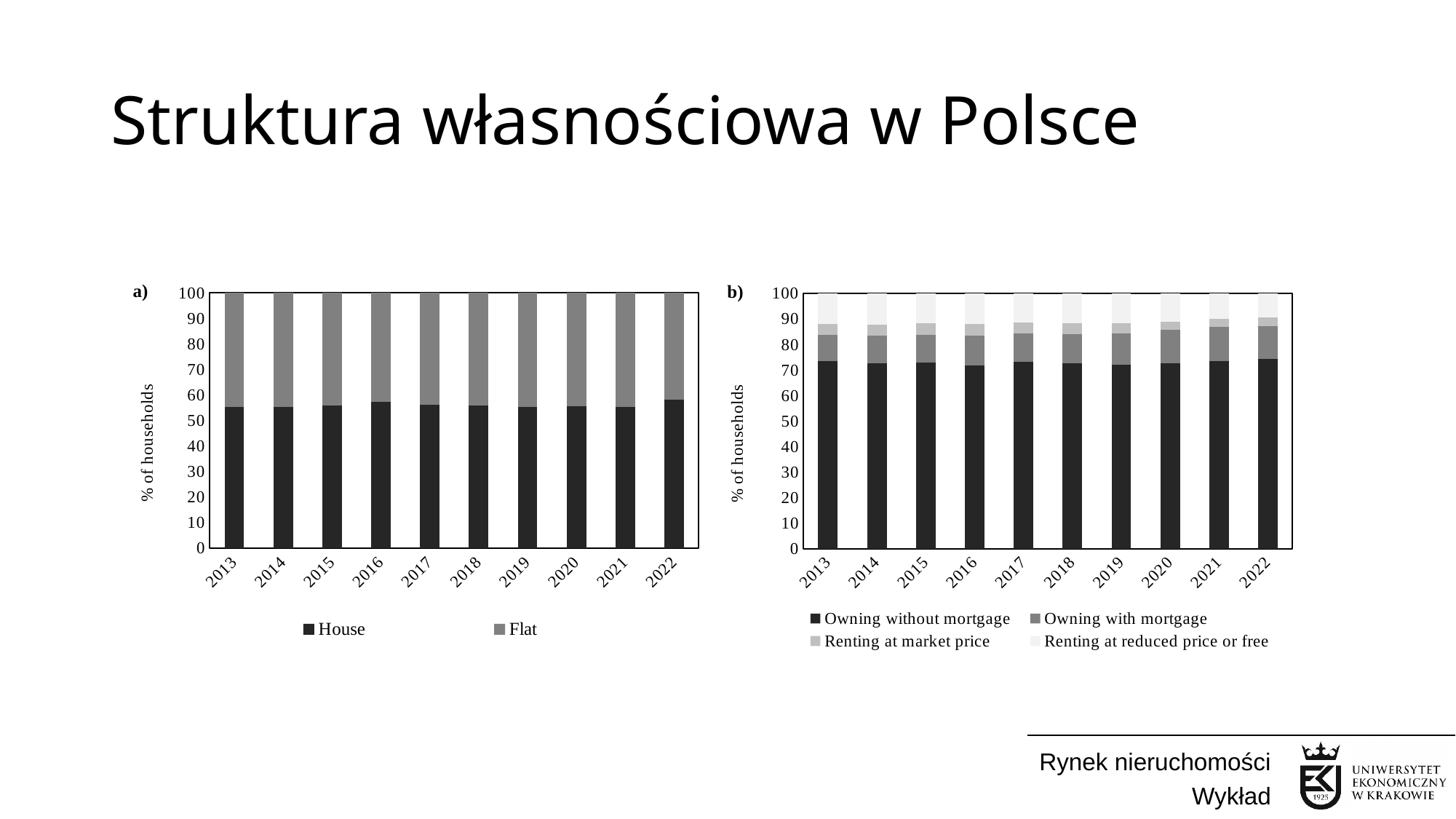
In chart a), is the value for House in 2013 greater or less than 50? greater In chart a), which is larger in 2013, House or Flat? House In chart b), how many series does the legend list? 4 In chart a), how many years are shown on the x axis? 10 What kind of chart is chart a)? stacked bar chart In chart a), what are the two legend entries? House and Flat In chart b), how many years are shown on the x axis? 10 In chart b), is the value for Owning without mortgage in 2022 greater or less than 80? less In chart a), is the value for House in 2022 greater or less than 70? less In chart b), what is the label of the y axis? % of households In chart a), how many series does the legend list? 2